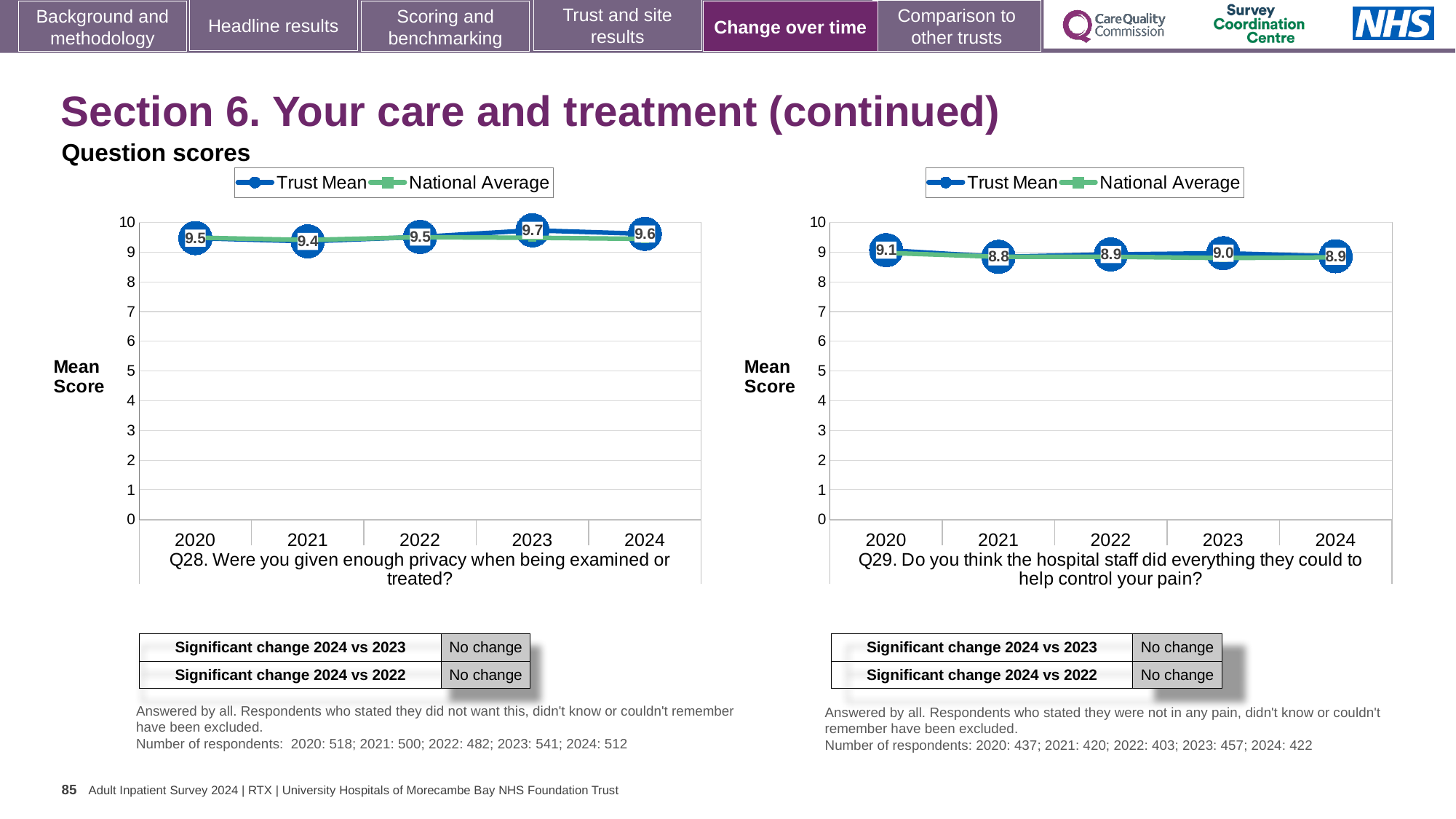
What type of chart is used for Q28 (left)? Line chart In the Q29 chart (right), which year has the lowest Trust Mean score? 2021 How many series does the legend of the Q29 chart (right) list? 2 In the Q29 chart (right), what is the Trust Mean score for 2020? 9.1 In the Q28 chart (left), which year has the highest Trust Mean score? 2023 What are the two series named in the legend of the Q28 chart (left)? Trust Mean and National Average In the Q28 chart (left), what is the Trust Mean score for 2023? 9.7 In the Q29 chart (right), is the Trust Mean score higher in 2020 or in 2024? 2020 In the Q28 chart (left), what is the difference between the Trust Mean scores for 2023 and 2021? 0.3 In the Q29 chart (right), what is the difference between the Trust Mean scores for 2020 and 2021? 0.3 In the Q28 chart (left), is the Trust Mean value for 2024 greater or less than 9? greater How many years are shown on the x axis of the Q28 chart (left)? 5